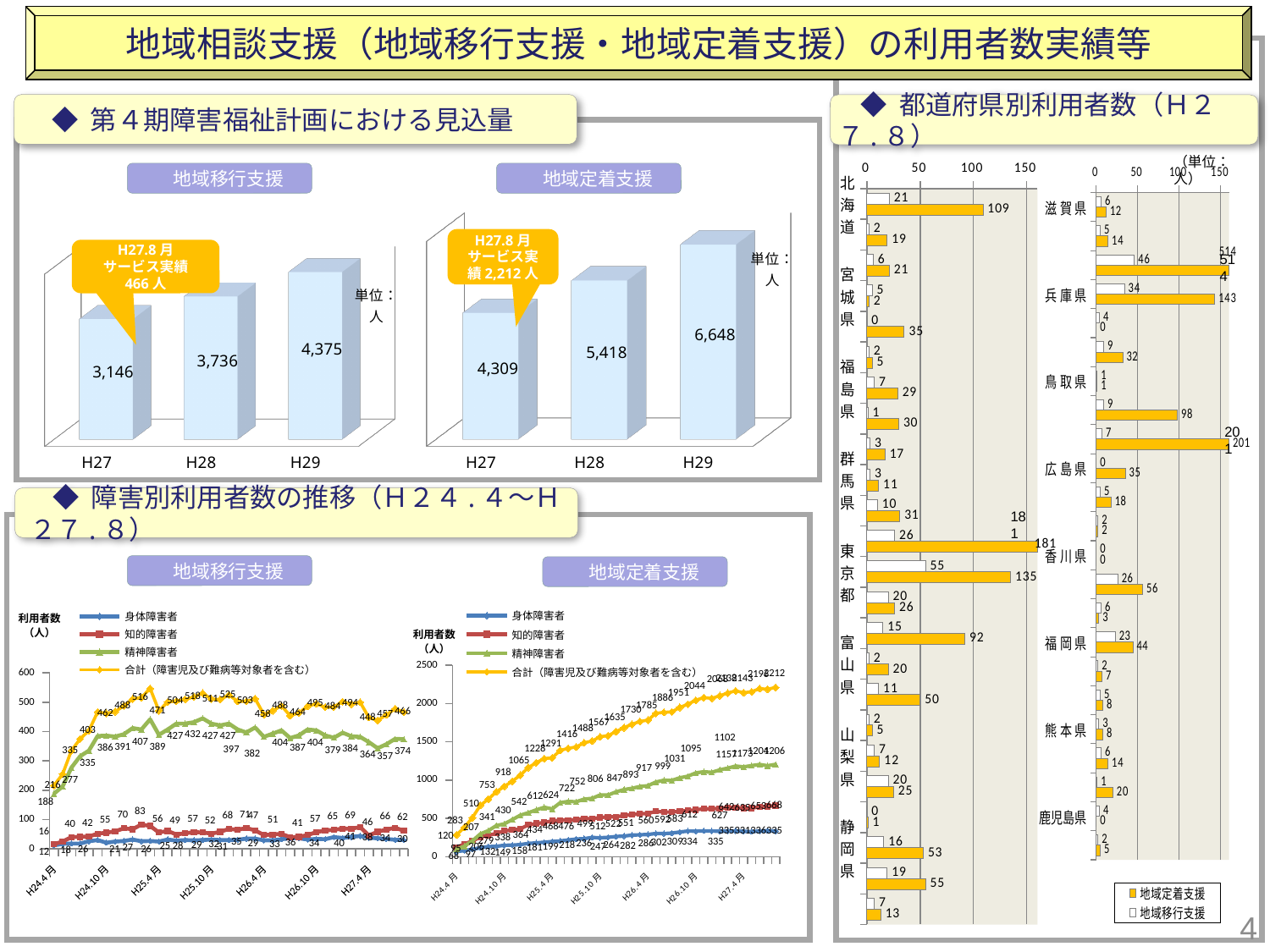
How many series does the legend list in the 地域移行支援 line chart under 障害別利用者数の推移? 4 Under 第4期障害福祉計画における見込量, which is larger for H28: the 地域移行支援 value or the 地域定着支援 value? 地域定着支援 In the 地域定着支援 bar chart under 第4期障害福祉計画における見込量, what is the difference between the H29 and H27 values? 2,339 In the 地域移行支援 bar chart under 第4期障害福祉計画における見込量, what is the difference between the H28 and H27 values? 590 In the 地域定着支援 bar chart under 第4期障害福祉計画における見込量, do the values rise or fall from H27 to H29? rise In the 地域定着支援 bar chart under 第4期障害福祉計画における見込量, what is the value for H27? 4,309 In the 地域移行支援 bar chart under 第4期障害福祉計画における見込量, what is the value for H29? 4,375 In the 都道府県別利用者数 chart, what is the 地域定着支援 value for 北海道? 109 How many years (categories) are shown in the 地域移行支援 bar chart under 第4期障害福祉計画における見込量? 3 In the 地域移行支援 bar chart under 第4期障害福祉計画における見込量, which year has the highest value? H29 In the 地域定着支援 bar chart under 第4期障害福祉計画における見込量, which year has the lowest value? H27 What kind of chart is used for the 地域定着支援 見込量 under 第4期障害福祉計画における見込量? bar chart